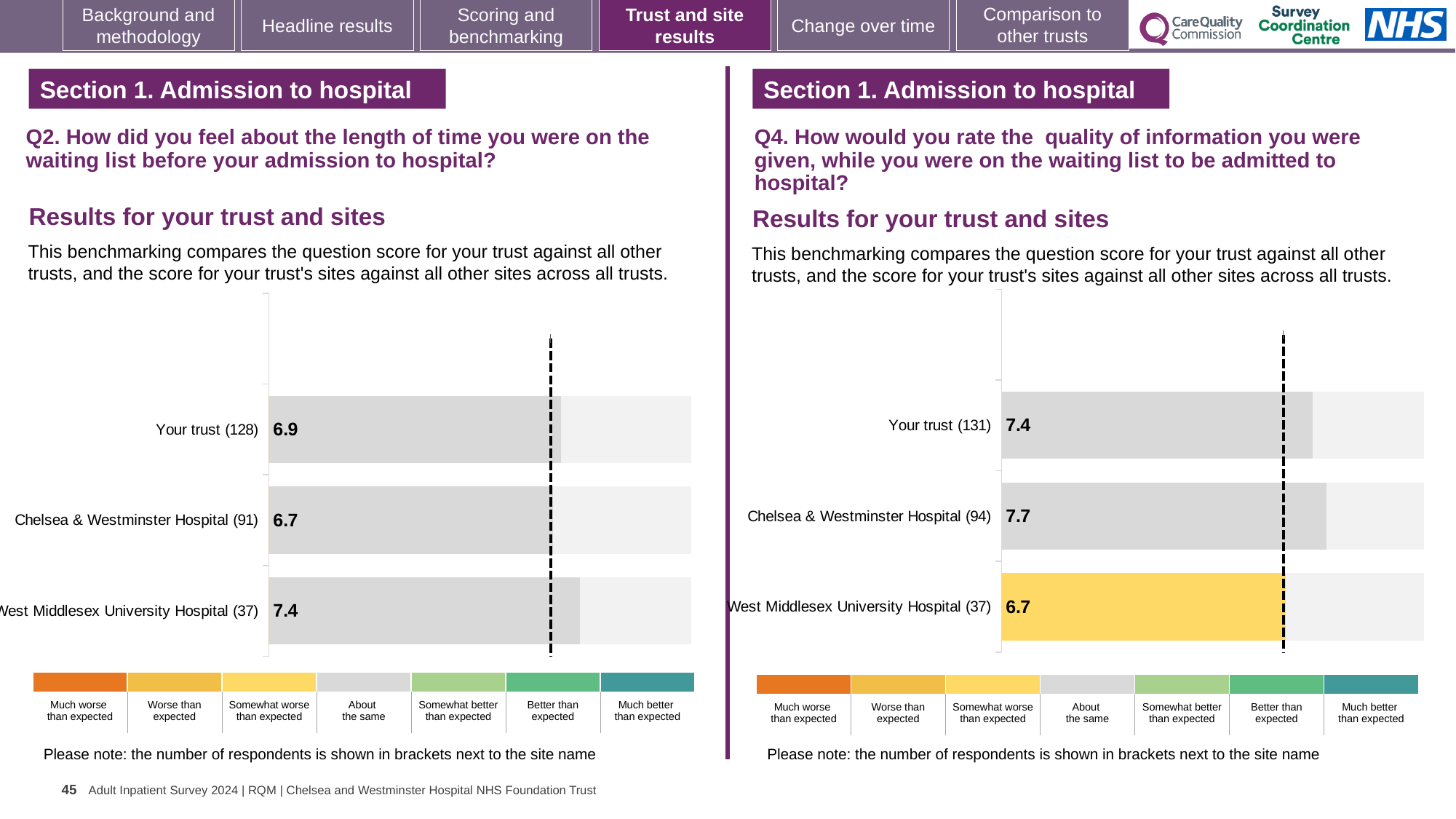
On the Q2 chart (left), which site or trust has the lowest score? Chelsea & Westminster Hospital (91) On the Q4 chart (right), what is the difference between the scores for Your trust (131) and West Middlesex University Hospital (37)? 0.7 What kind of chart is used on the Q2 chart (left)? Bar chart On the Q4 chart (right), which site or trust has the highest score? Chelsea & Westminster Hospital (94) On the Q4 chart (right), what is the score for Chelsea & Westminster Hospital (94)? 7.7 On the Q2 chart (left), how many bars are plotted? 3 On the Q4 chart (right), what is the score for West Middlesex University Hospital (37)? 6.7 On the Q4 chart (right), which bar is coloured yellow rather than grey? West Middlesex University Hospital (37) On the Q2 chart (left), what is the score for Your trust (128)? 6.9 On the Q2 chart (left), what is the difference between the scores for West Middlesex University Hospital (37) and Chelsea & Westminster Hospital (91)? 0.7 On the Q2 chart (left), what is the score for West Middlesex University Hospital (37)? 7.4 On the Q4 chart (right), which is larger: the score for Your trust (131) or the score for West Middlesex University Hospital (37)? Your trust (131)